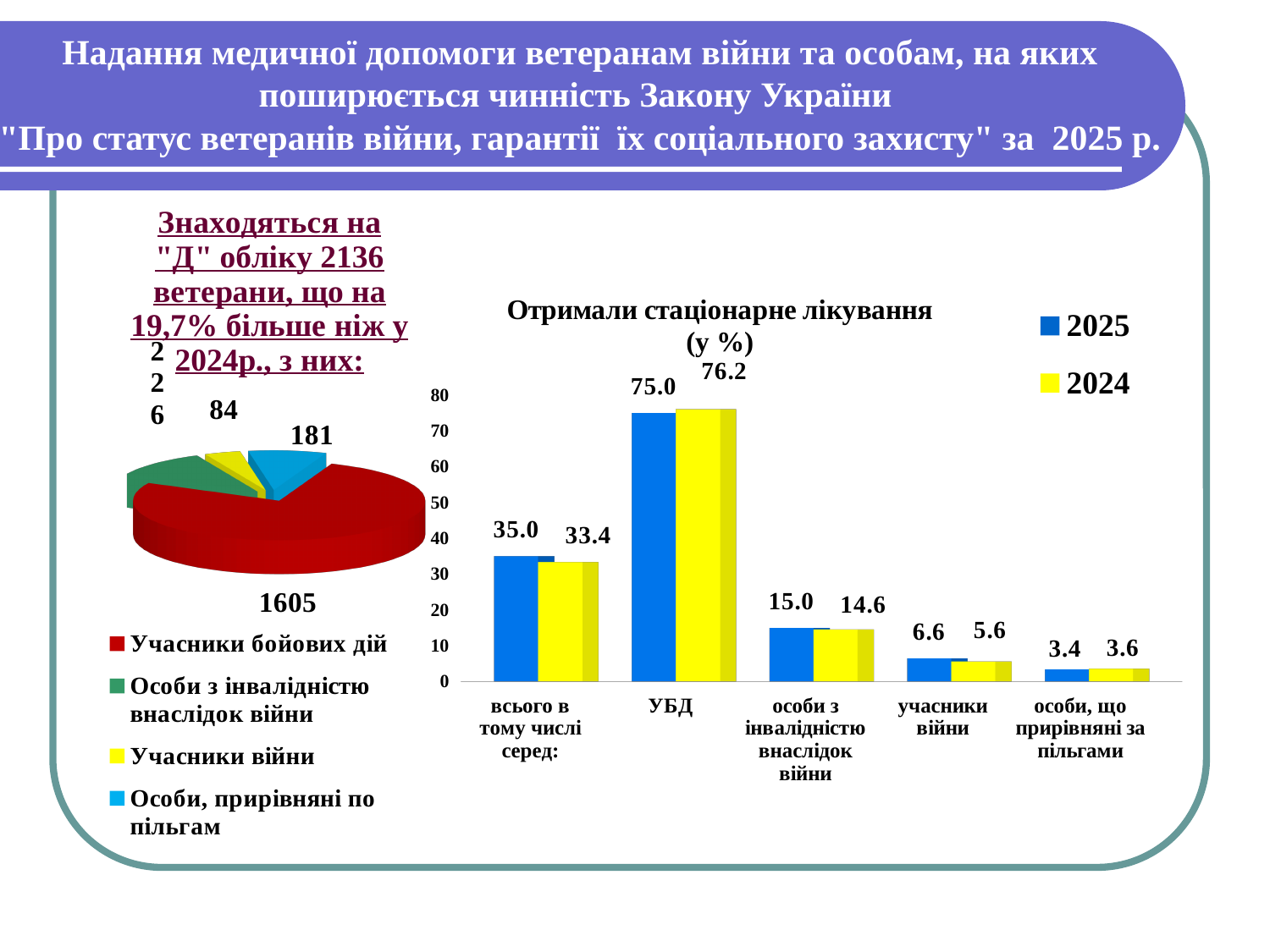
In the bar chart 'Отримали стаціонарне лікування (у %)', what is the difference between the 2025 and 2024 values for 'особи з інвалідністю внаслідок війни'? 0.4 In the bar chart 'Отримали стаціонарне лікування (у %)', how many categories are shown on the x axis? 5 In the bar chart 'Отримали стаціонарне лікування (у %)', how many series does the legend list? 2 In the bar chart 'Отримали стаціонарне лікування (у %)', which category has the highest 2024 value? УБД What kind of chart is the chart on the left side of the slide? Pie chart In the pie chart on the left, what is the value for 'Особи, прирівняні по пільгам'? 181 In the bar chart 'Отримали стаціонарне лікування (у %)', which category has the lowest 2025 value? особи, що прирівняні за пільгами In the pie chart on the left, what is the value for 'Учасники бойових дій'? 1605 In the bar chart 'Отримали стаціонарне лікування (у %)', which is larger for УБД: the 2025 value or the 2024 value? 2024 In the bar chart 'Отримали стаціонарне лікування (у %)', what is the 2024 value for 'учасники війни'? 5.6 In the bar chart 'Отримали стаціонарне лікування (у %)', what is the 2025 value for УБД? 75.0 In the bar chart 'Отримали стаціонарне лікування (у %)', what is the 2025 value for 'всього в тому числі серед:'? 35.0